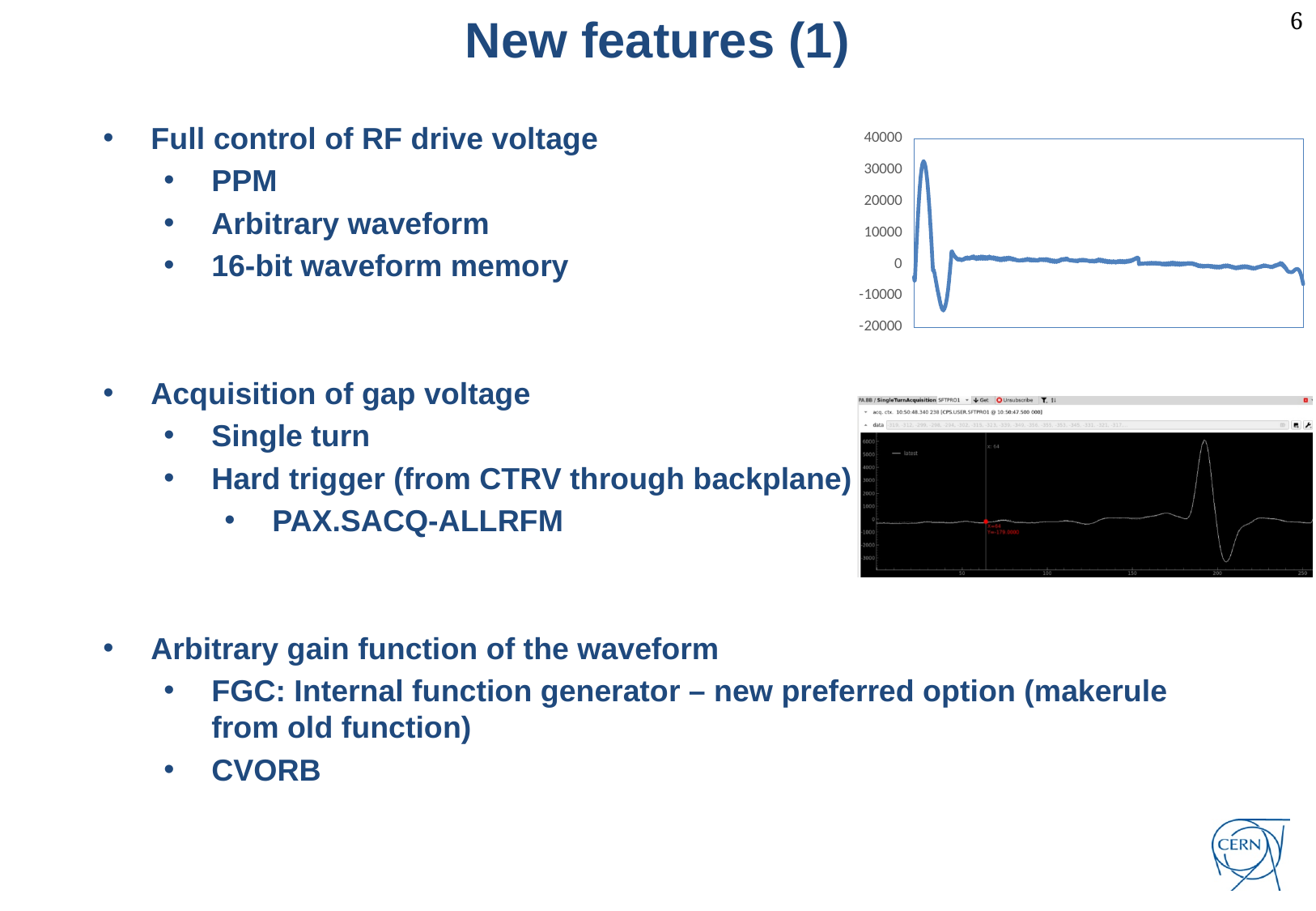
In the top-right chart, is the highest value of the line greater or less than 20000? greater How many series does the legend of the bottom-right chart list? 1 What colour is the line in the top-right chart? blue In the bottom-right chart, is the peak of the line near x=200 greater or less than 4000? greater What is the legend entry shown in the bottom-right chart? latest In the bottom-right chart, is the dip of the line just after x=200 greater or less than -2000? less What kind of chart is shown in the bottom-right screenshot on the slide? line chart In the top-right chart, after the initial spike, does the line stay close to 0 or close to 20000? close to 0 What kind of chart is the top-right chart on the slide? line chart